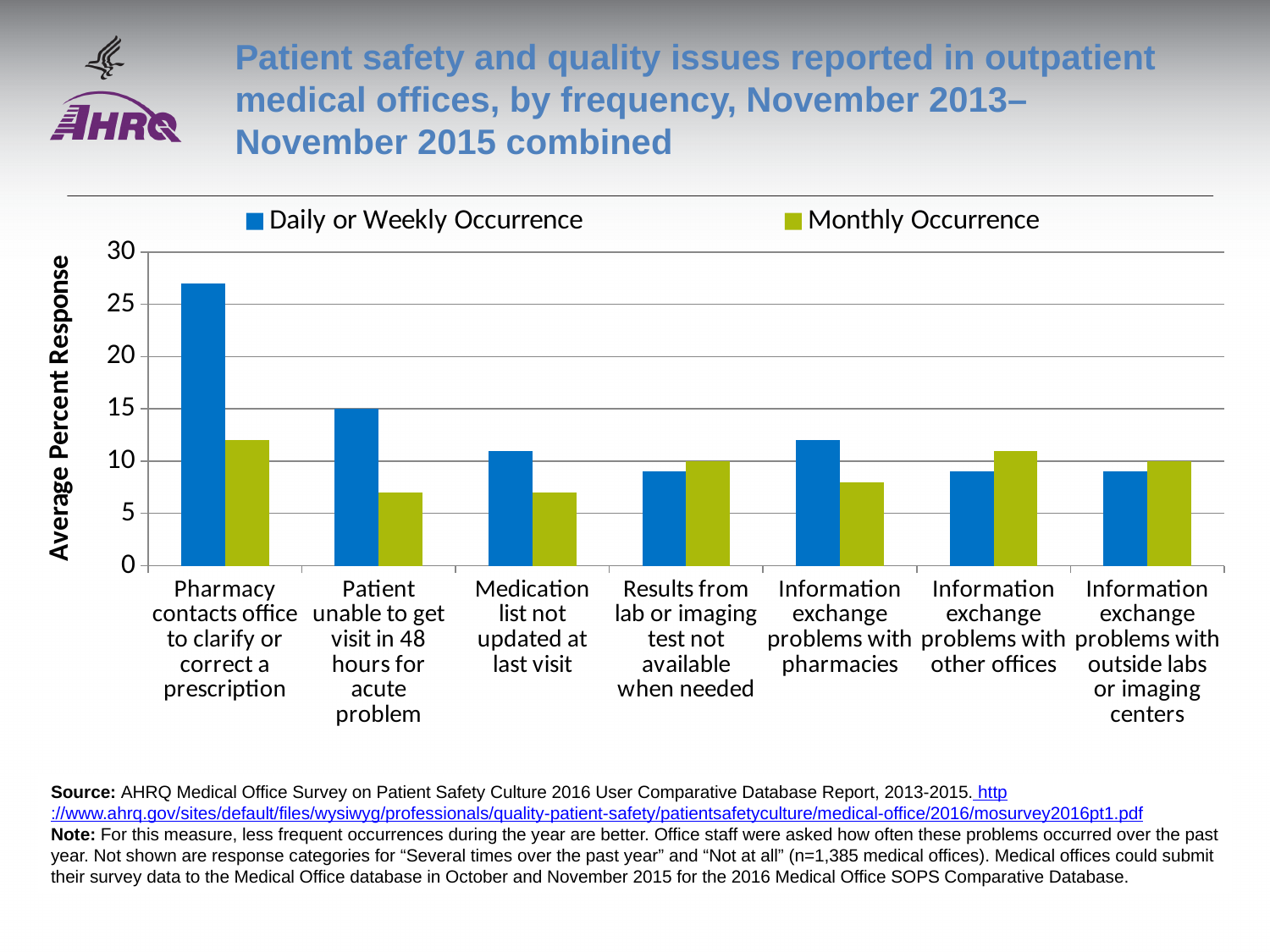
Is the Daily or Weekly Occurrence value for 'Information exchange problems with pharmacies' greater or less than 10? greater For 'Information exchange problems with other offices', which is larger: Daily or Weekly Occurrence or Monthly Occurrence? Monthly Occurrence For 'Pharmacy contacts office to clarify or correct a prescription', which is larger: Daily or Weekly Occurrence or Monthly Occurrence? Daily or Weekly Occurrence How many series does the legend list? 2 Is the Daily or Weekly Occurrence value for 'Pharmacy contacts office to clarify or correct a prescription' greater or less than 25? greater What is the label on the vertical axis? Average Percent Response Which category has the highest Daily or Weekly Occurrence value? Pharmacy contacts office to clarify or correct a prescription How many patient safety issue categories are shown on the x axis? 7 What colour represents the Daily or Weekly Occurrence series? Blue What kind of chart is shown on the slide? Bar chart Is the Monthly Occurrence value for 'Pharmacy contacts office to clarify or correct a prescription' greater or less than 15? less